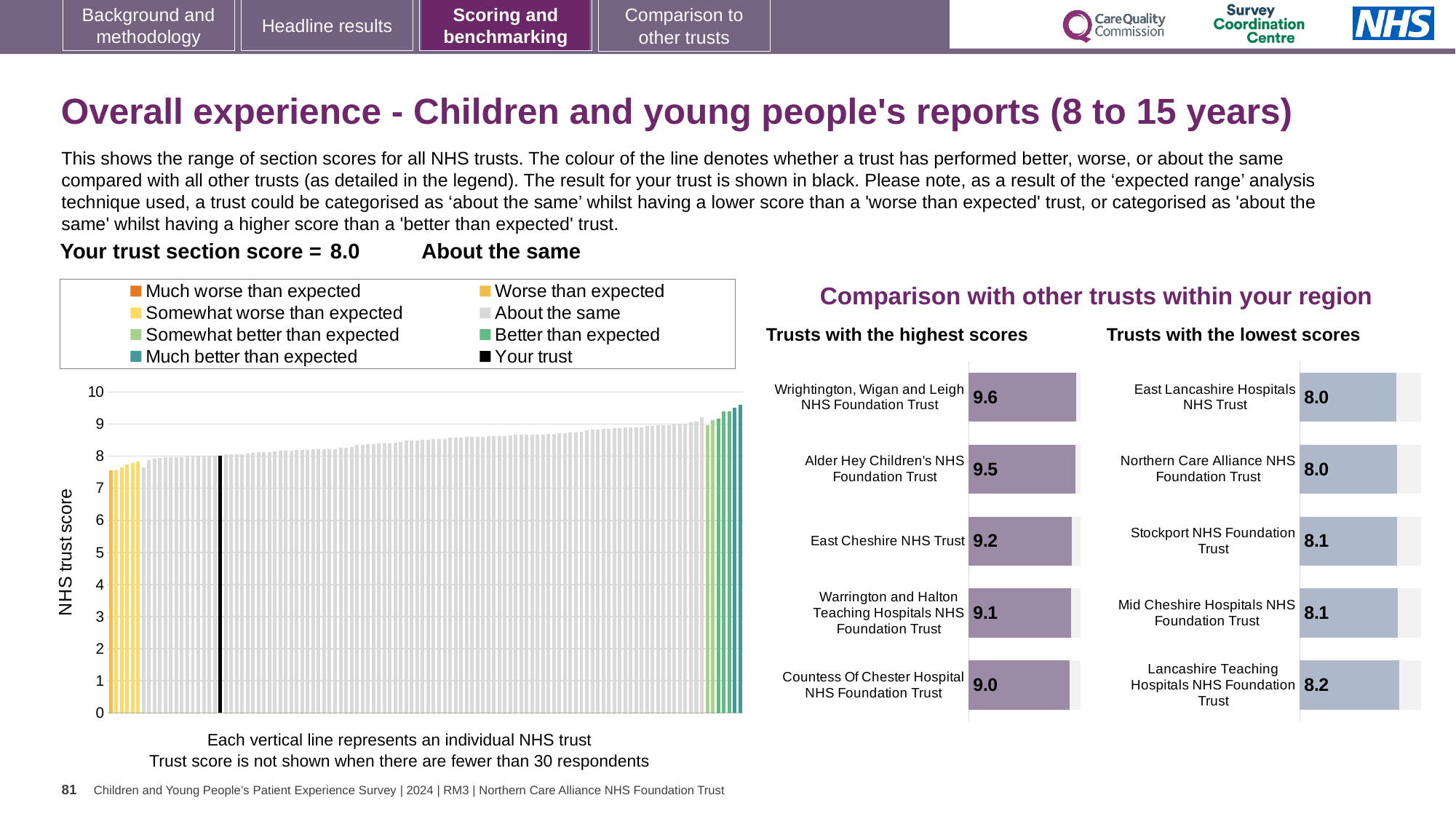
In the 'Trusts with the highest scores' chart, which trust has the lowest score? Countess Of Chester Hospital NHS Foundation Trust In the 'Trusts with the highest scores' chart, what is the difference between the scores of Wrightington, Wigan and Leigh NHS Foundation Trust and Countess Of Chester Hospital NHS Foundation Trust? 0.6 What kind of chart is the 'NHS trust score' chart on the left? Bar chart In the 'Trusts with the highest scores' chart, which trust has the highest score? Wrightington, Wigan and Leigh NHS Foundation Trust In the 'Trusts with the lowest scores' chart, which trust has the highest score? Lancashire Teaching Hospitals NHS Foundation Trust In the 'Trusts with the highest scores' chart, what is the score for Wrightington, Wigan and Leigh NHS Foundation Trust? 9.6 In the 'Trusts with the lowest scores' chart, what is the score for Lancashire Teaching Hospitals NHS Foundation Trust? 8.2 How many entries does the legend of the 'NHS trust score' chart on the left list? 8 In the 'Trusts with the highest scores' chart, which has the higher score: Alder Hey Children's NHS Foundation Trust or East Cheshire NHS Trust? Alder Hey Children's NHS Foundation Trust How many trusts are shown in the 'Trusts with the lowest scores' chart? 5 In the 'NHS trust score' chart on the left, do the bar heights rise or fall from left to right? Rise In the 'Trusts with the highest scores' chart, what is the score for East Cheshire NHS Trust? 9.2